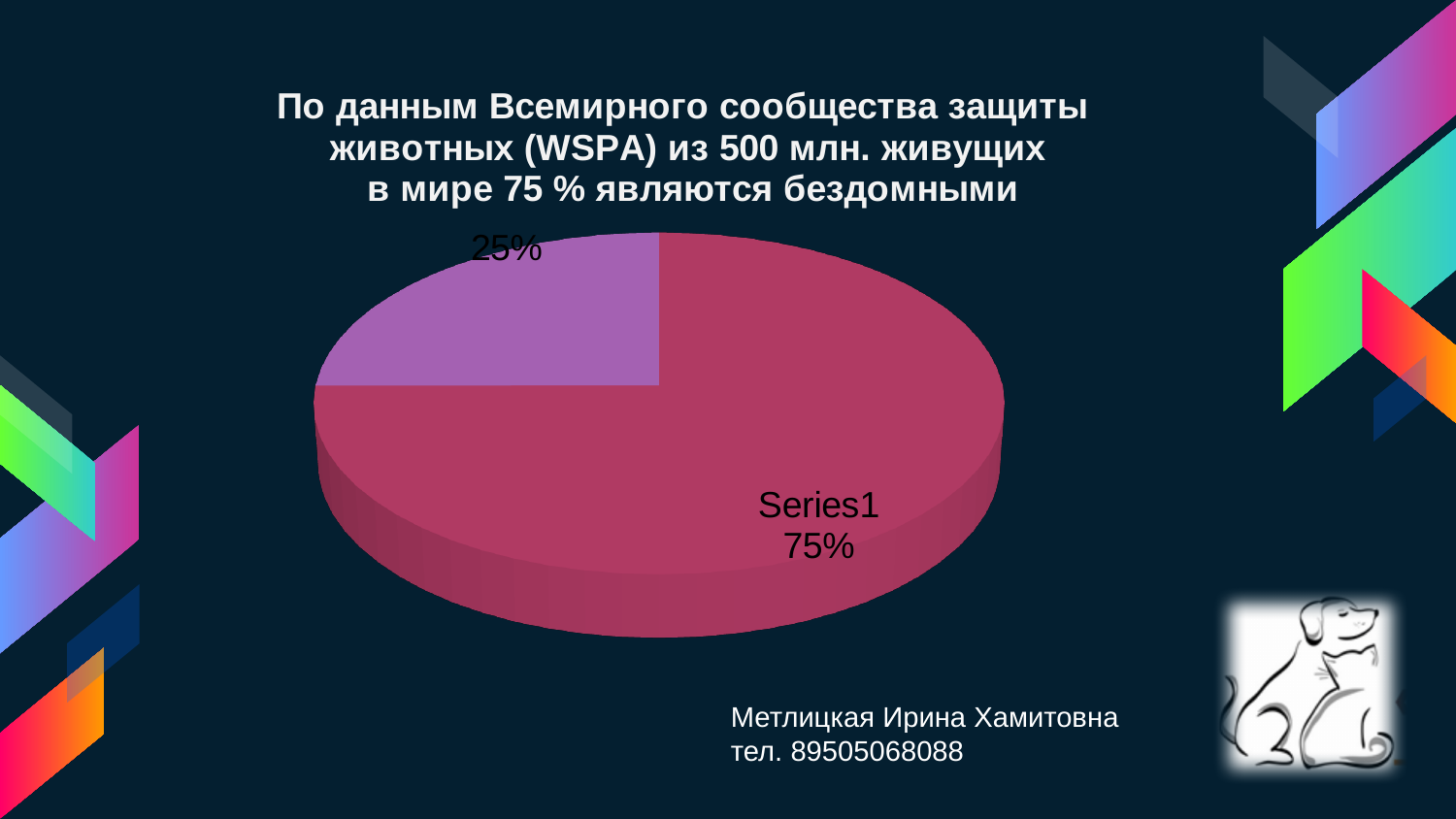
What percentage is shown on the large red slice labelled Series1? 75% What kind of chart is shown on the slide? pie chart Which slice of the pie chart is the largest? Series1 (75%) What share of the pie does the Series1 slice take up? 75% What is the difference in percentage points between the 75% slice and the 25% slice? 50 Which slice of the pie chart is the smallest? the purple slice (25%) According to the slide title, how many animals living in the world does the WSPA data refer to? 500 млн. Which is larger, the red Series1 slice or the purple slice? the red Series1 slice What label is printed on the large red slice of the pie chart? Series1 What percentage is shown on the smaller purple slice of the pie chart? 25% How many slices does the pie chart have? 2 What is the total of the two slice percentages shown on the pie chart? 100%